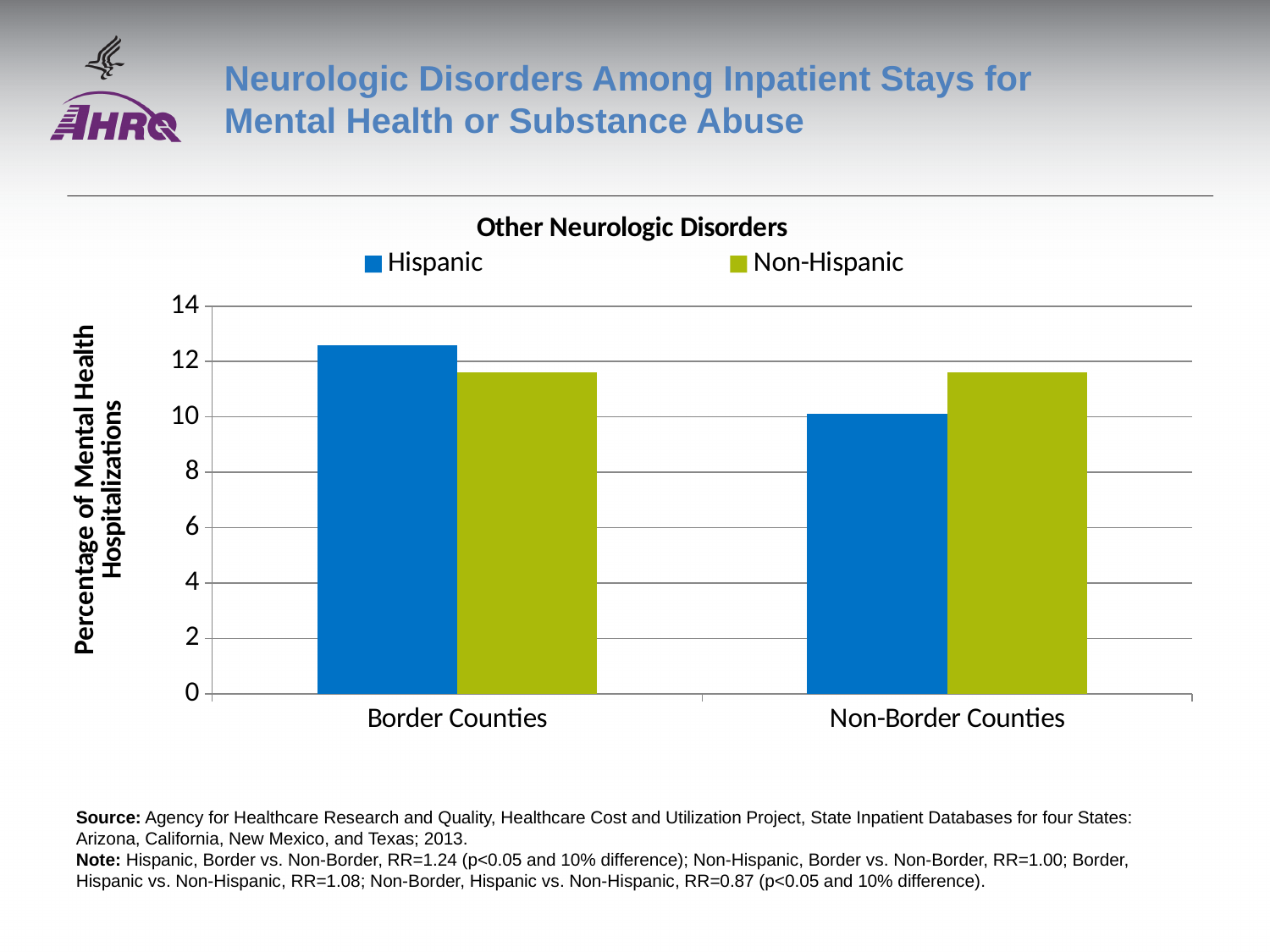
How many series does the legend list? 2 What kind of chart is shown on the slide? bar chart In Non-Border Counties, which is larger: the Hispanic value or the Non-Hispanic value? Non-Hispanic Is the Hispanic value for Border Counties greater or less than 12? greater How many categories are shown on the x axis? 2 Is the Non-Hispanic value for Border Counties greater or less than 10? greater Which bar is the tallest in the chart? Hispanic, Border Counties What is the title of the chart? Other Neurologic Disorders Which bar is the shortest in the chart? Hispanic, Non-Border Counties Is the Hispanic value for Non-Border Counties greater or less than 12? less In Border Counties, which is larger: the Hispanic value or the Non-Hispanic value? Hispanic What colour are the Non-Hispanic bars? green